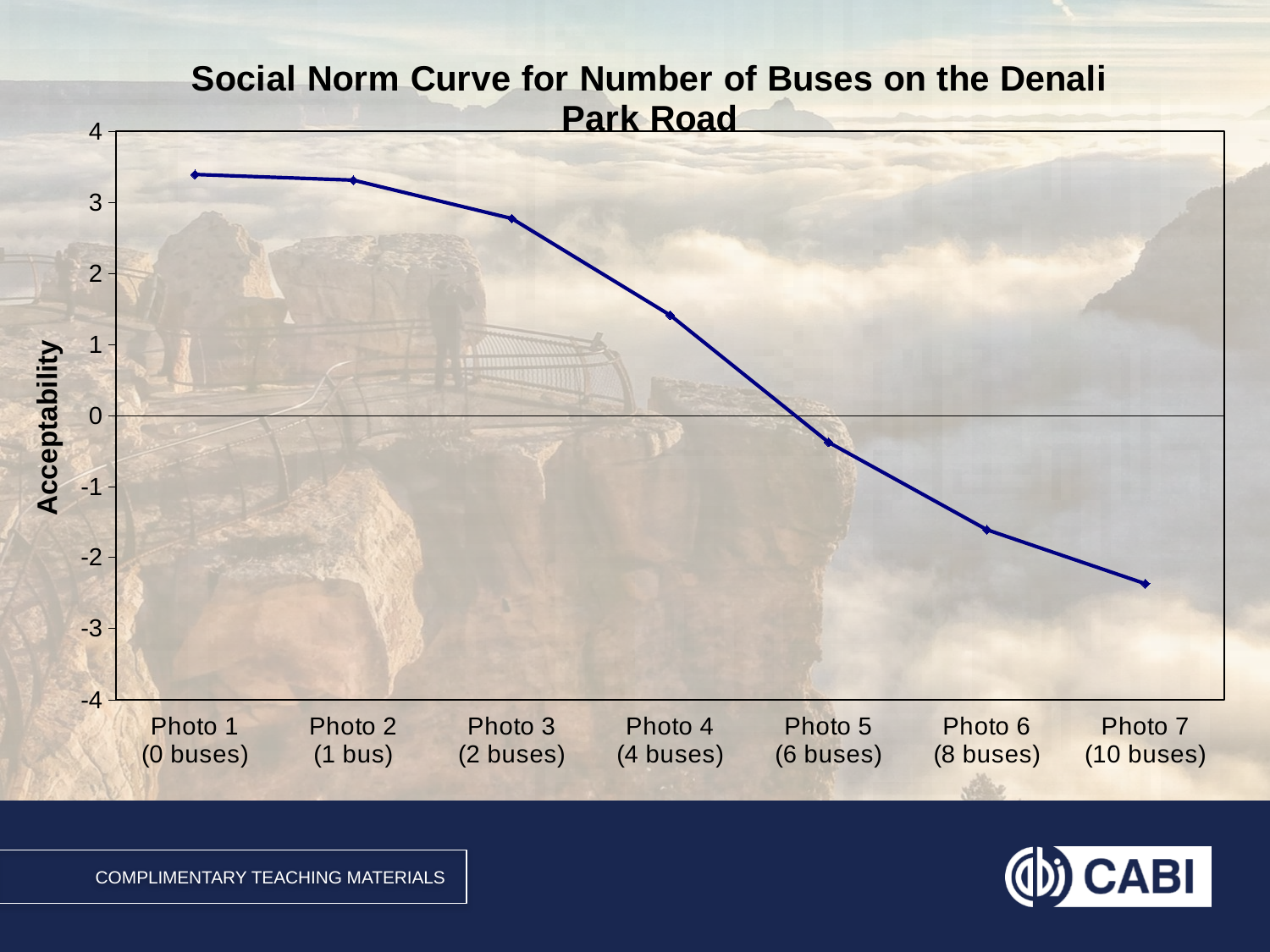
How many photo categories are plotted along the x axis? 7 Is the acceptability value for Photo 1 (0 buses) greater or less than 3? greater Is the acceptability value for Photo 6 (8 buses) greater or less than -2? greater Which has the higher acceptability value, Photo 3 (2 buses) or Photo 5 (6 buses)? Photo 3 (2 buses) Do the acceptability values rise or fall as the number of buses increases from Photo 1 to Photo 7? fall Is the acceptability value for Photo 4 (4 buses) greater or less than 2? less What is the label on the vertical axis of the chart? Acceptability What kind of chart is shown on the slide? line chart What is the title of the chart? Social Norm Curve for Number of Buses on the Denali Park Road Which photo has the lowest acceptability value? Photo 7 (10 buses)